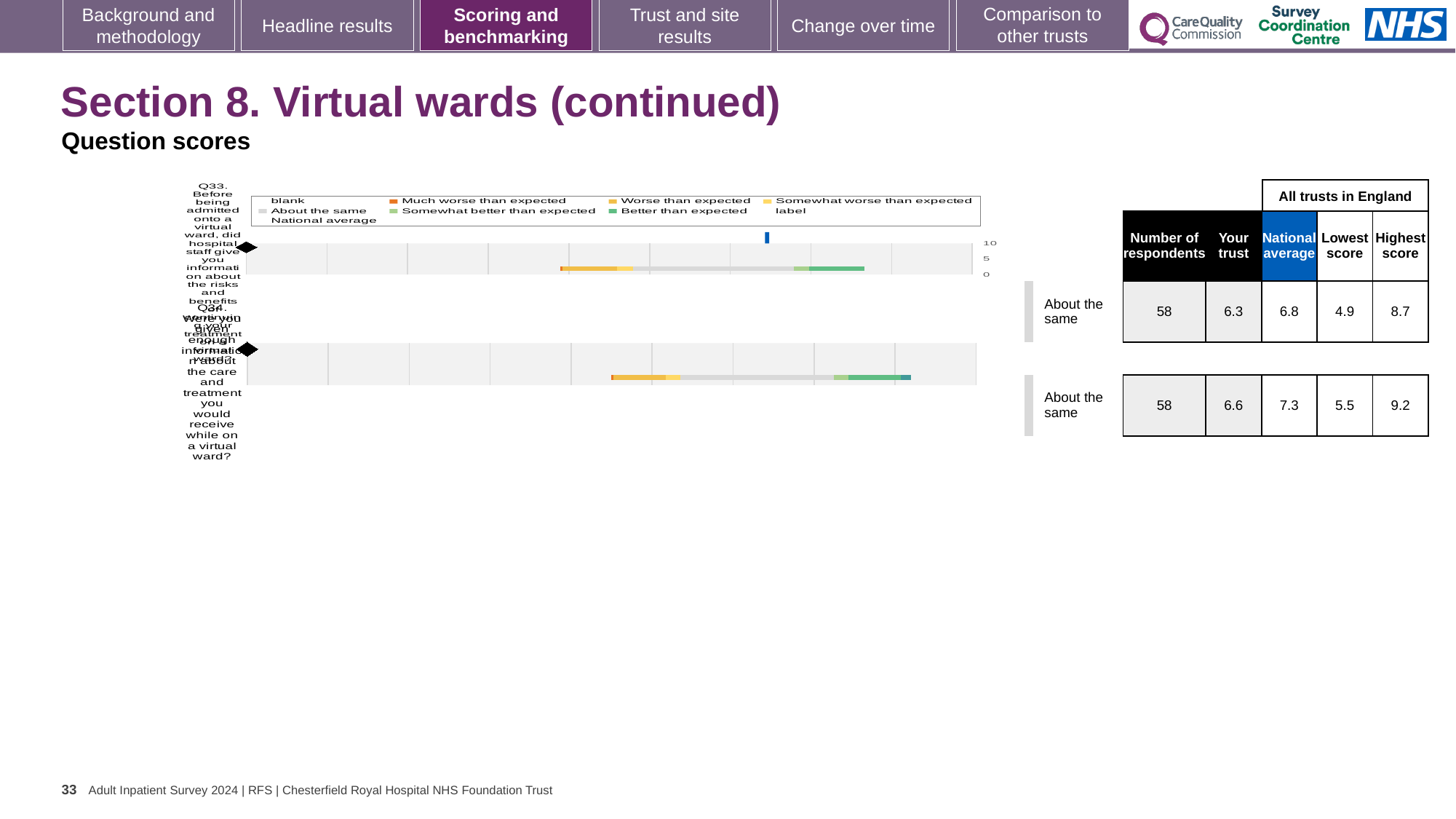
What is the lowest score among all trusts in England for Q33? 4.9 What is the difference between the national average and the 'Your trust' score for Q34? 0.7 Which question has the higher 'Your trust' score, Q33 or Q34? Q34 What kind of chart is used to show the question scores for Q33 and Q34? bar chart What is the highest score among all trusts in England for Q34? 9.2 What is the difference between the national average and the 'Your trust' score for Q33? 0.5 What is the national average score for Q34 (enough information about care and treatment on a virtual ward)? 7.3 How many respondents answered Q33? 58 What is the 'Your trust' score for Q33 (information about the risks and benefits of a virtual ward)? 6.3 How many questions (bars) are shown in the chart? 2 What benchmark category is shown for both Q33 and Q34? About the same Which question has the higher 'Highest score' among all trusts in England, Q33 or Q34? Q34